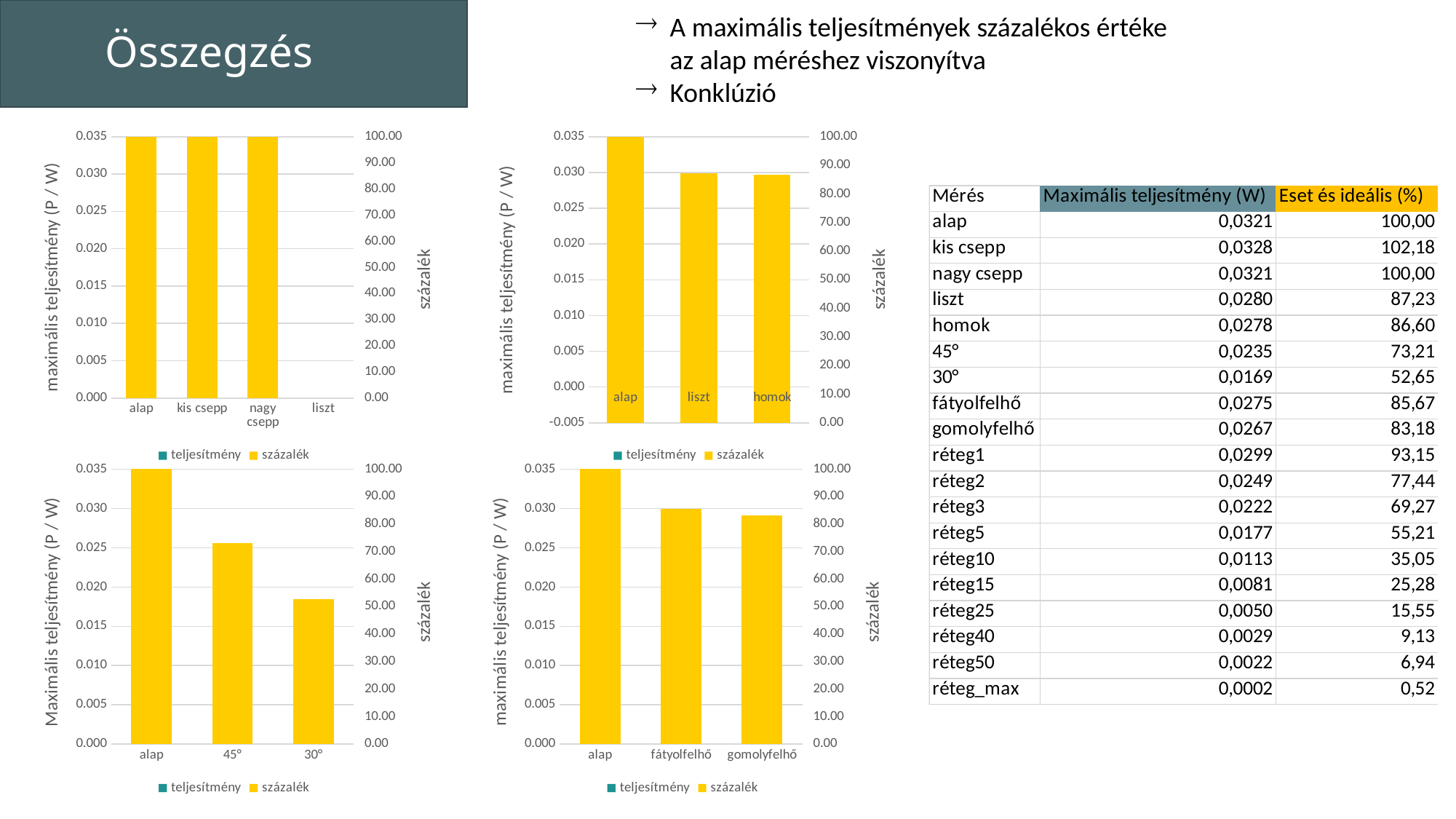
How many categories are shown on the x axis of the bottom-left chart? 3 In the top-right chart, is the bar for liszt greater or less than 80.00 on the right-hand százalék axis? greater What are the two legend entries of the bottom-right chart? teljesítmény, százalék In the bottom-left chart, which category has the highest bar? alap In the bottom-left chart, is the bar for 30° greater or less than 60.00 on the right-hand százalék axis? less How many series does the legend of the bottom-left chart list? 2 What kind of chart is the bottom-left chart with categories alap, 45° and 30°? bar chart In the bottom-left chart, do the bars rise or fall from left to right along the x axis? fall In the bottom-left chart, which category has the lowest bar? 30° In the bottom-left chart, is the bar for 45° greater or less than 60.00 on the right-hand százalék axis? greater How many category labels are shown on the x axis of the top-left chart? 4